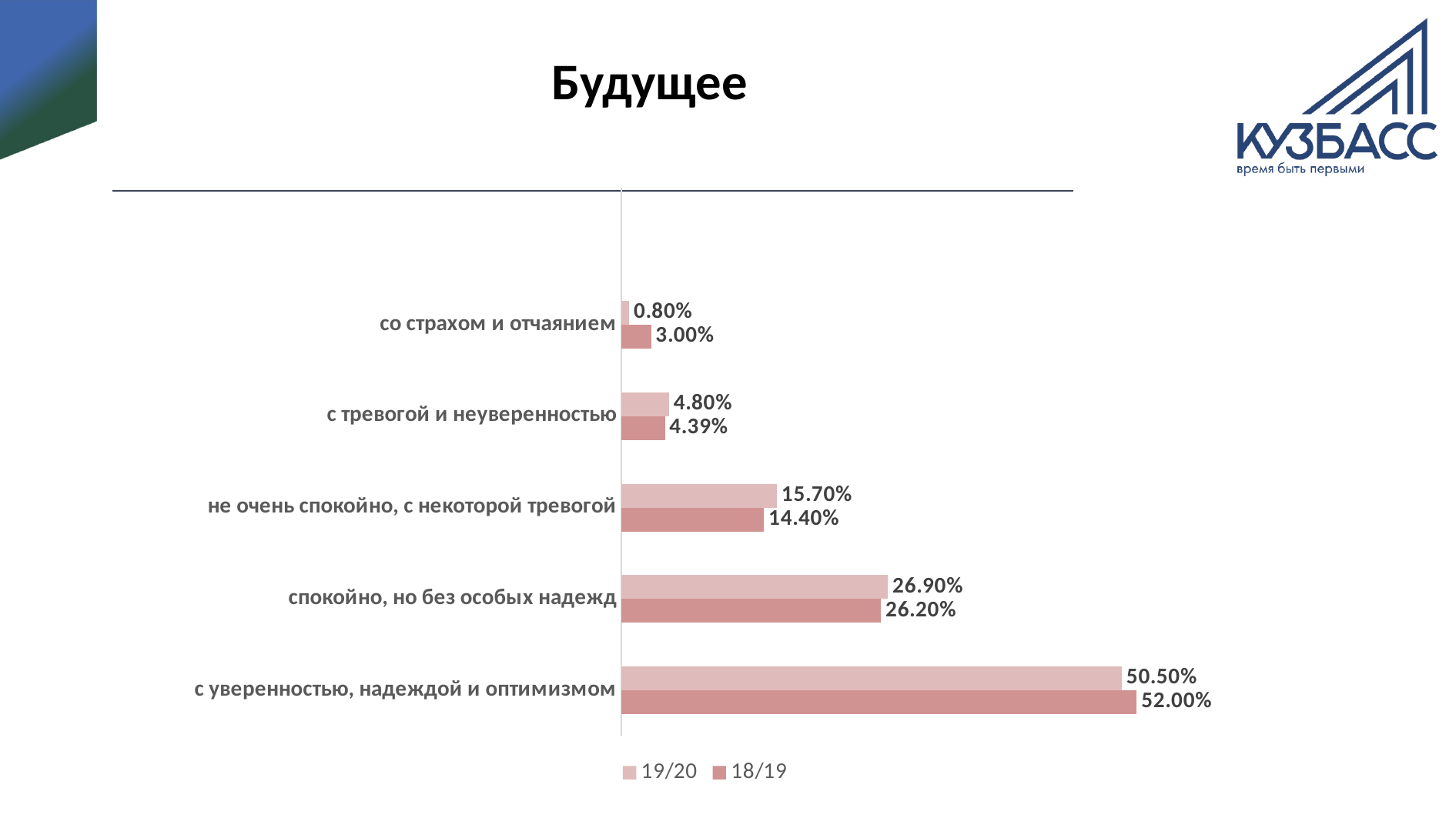
Which category has the highest 19/20 value? с уверенностью, надеждой и оптимизмом Which category has the lowest 18/19 value? со страхом и отчаянием What is the 19/20 value for 'с уверенностью, надеждой и оптимизмом'? 50.50% What is the title of the chart? Будущее What kind of chart is shown on the slide? bar chart How many series does the legend list? 2 For 'с уверенностью, надеждой и оптимизмом', which series has the larger value, 19/20 or 18/19? 18/19 What is the 18/19 value for 'не очень спокойно, с некоторой тревогой'? 14.40% What is the difference between the 19/20 and 18/19 values for 'не очень спокойно, с некоторой тревогой'? 1.30% What is the 18/19 value for 'со страхом и отчаянием'? 3.00% How many categories are shown on the chart? 5 What is the difference between the 18/19 and 19/20 values for 'со страхом и отчаянием'? 2.20%